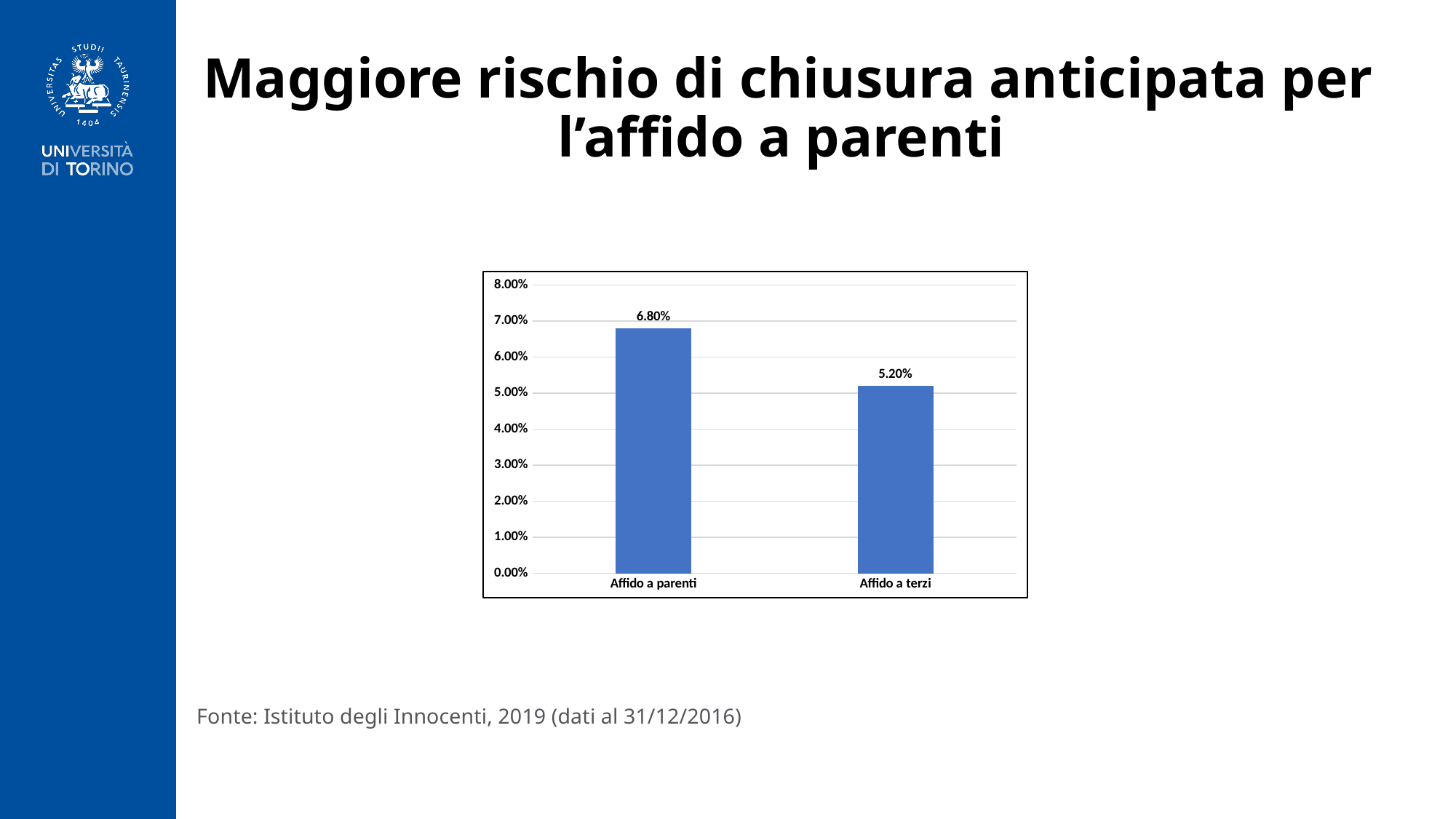
Which category has the highest value? Affido a parenti What colour are the bars in the chart? blue What is the highest value shown on the y axis? 8.00% What is the value for Affido a terzi? 5.20% Which is larger, the value for Affido a parenti or the value for Affido a terzi? Affido a parenti What is the difference between the values for Affido a parenti and Affido a terzi? 1.60% Which category has the lowest value? Affido a terzi What kind of chart is shown on the slide? bar chart What is the value for Affido a parenti? 6.80% How many categories are shown on the x axis? 2 Is the value for Affido a terzi greater or less than 6.00%? less Is the value for Affido a parenti greater or less than 6.00%? greater